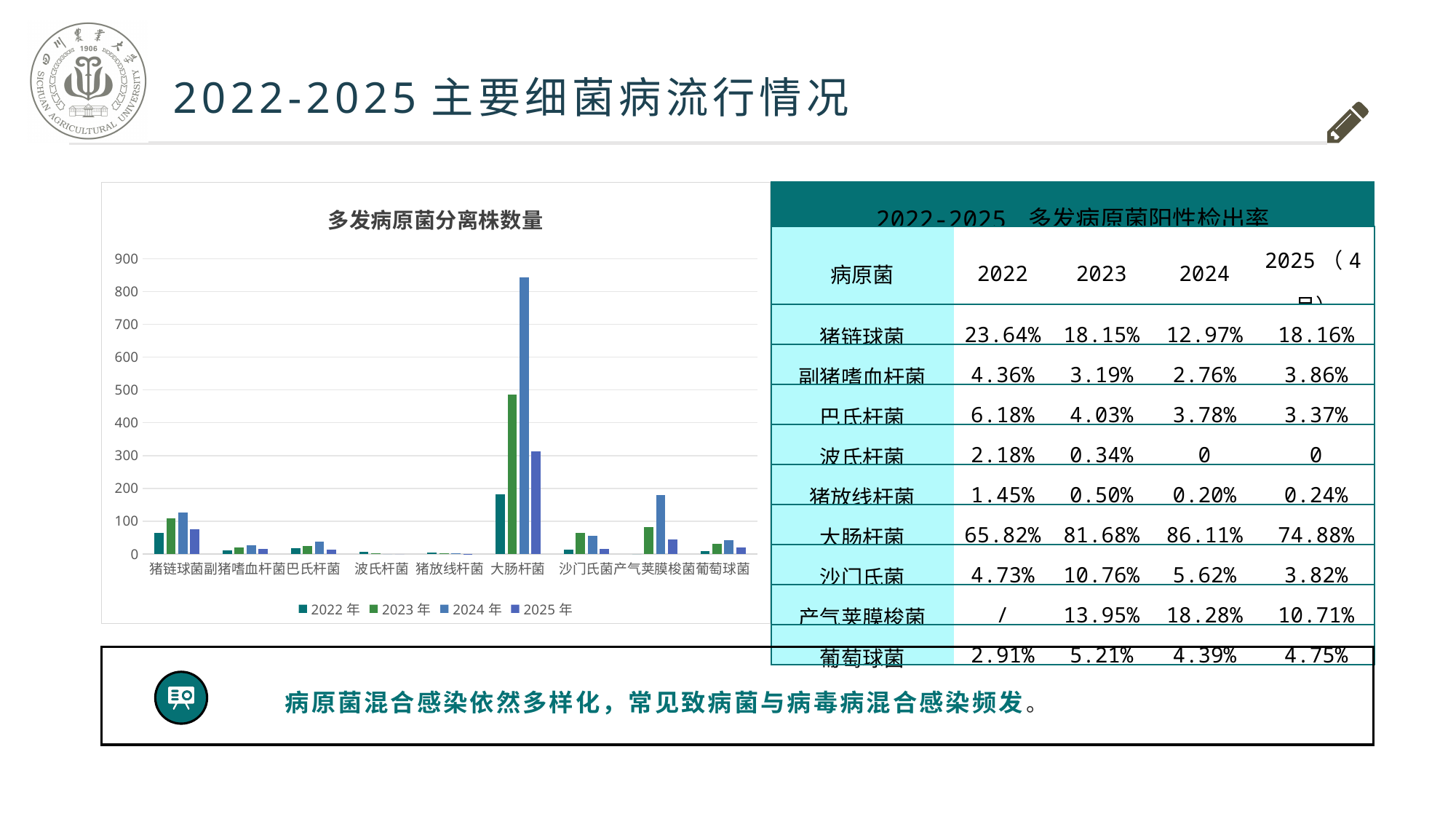
Is the 2024 年 value for 产气荚膜梭菌 greater or less than 200? less What is the title of the bar chart? 多发病原菌分离株数量 What kind of chart is shown on the slide? bar chart How many pathogen categories are shown on the x axis of the bar chart? 9 For 大肠杆菌, which year series has the highest bar? 2024 年 From 2022 年 to 2024 年, do the bars for 大肠杆菌 rise or fall? rise Which is larger for 猪链球菌: the 2022 年 value or the 2023 年 value? 2023 年 Which pathogen category has the tallest bar in the chart? 大肠杆菌 Is the 2024 年 value for 大肠杆菌 greater or less than 800? greater How many series does the legend of the bar chart list? 4 Is the 2023 年 value for 大肠杆菌 greater or less than 400? greater Which is larger for 产气荚膜梭菌: the 2023 年 value or the 2024 年 value? 2024 年